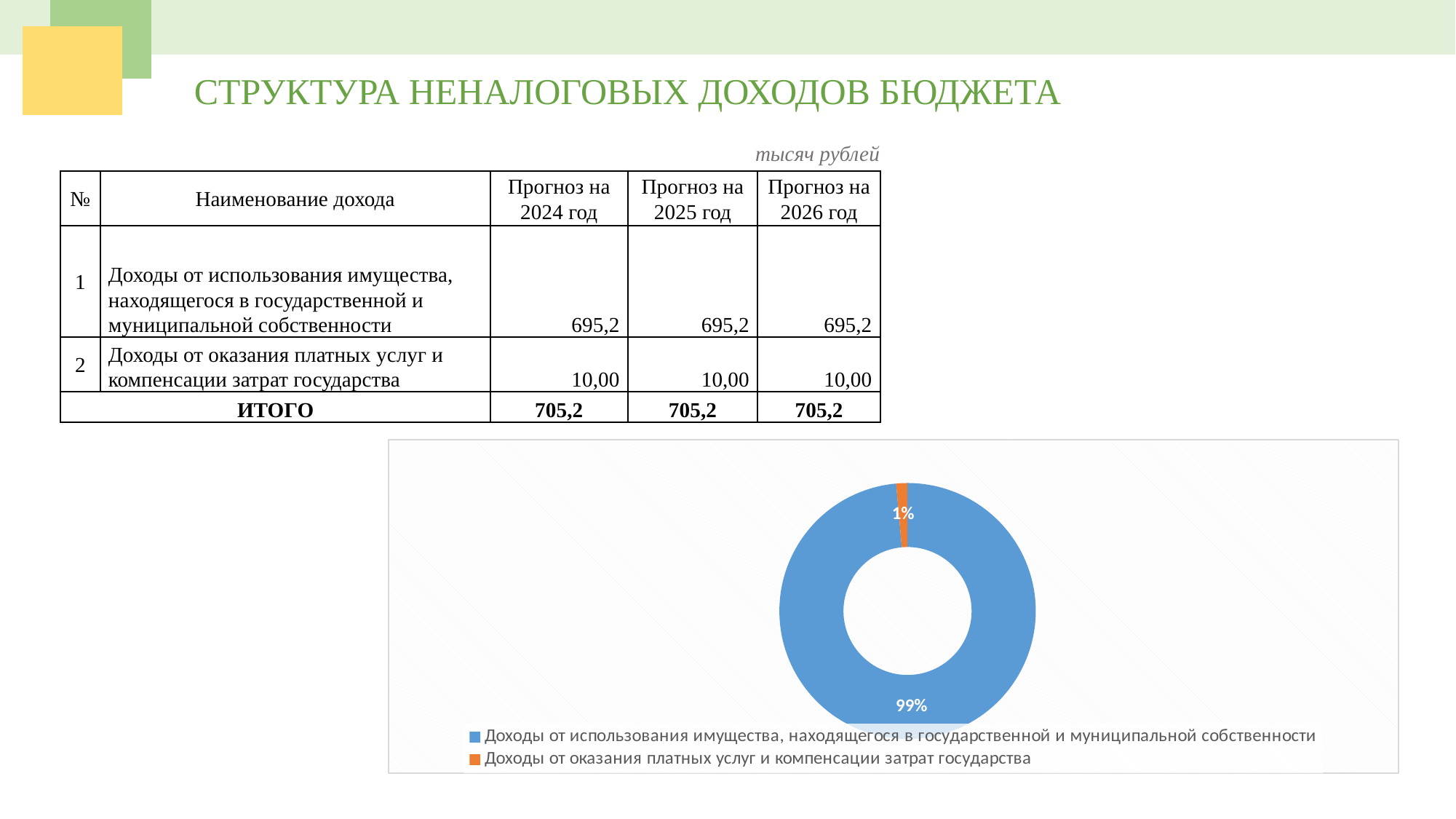
What kind of chart is shown on the slide? doughnut chart What share of the doughnut chart is labelled for 'Доходы от использования имущества, находящегося в государственной и муниципальной собственности'? 99% How many entries does the legend of the doughnut chart list? 2 How many slices does the doughnut chart have? 2 Which category has the smallest slice in the doughnut chart? Доходы от оказания платных услуг и компенсации затрат государства What is the difference in percentage points between the two slices of the doughnut chart? 98 What share of the doughnut chart is labelled for 'Доходы от оказания платных услуг и компенсации затрат государства'? 1% Where is the legend placed relative to the doughnut chart? below the chart Which slice is larger in the doughnut chart: the blue one or the orange one? the blue one Which category has the largest slice in the doughnut chart? Доходы от использования имущества, находящегося в государственной и муниципальной собственности What colour is the slice for 'Доходы от оказания платных услуг и компенсации затрат государства' in the doughnut chart? orange